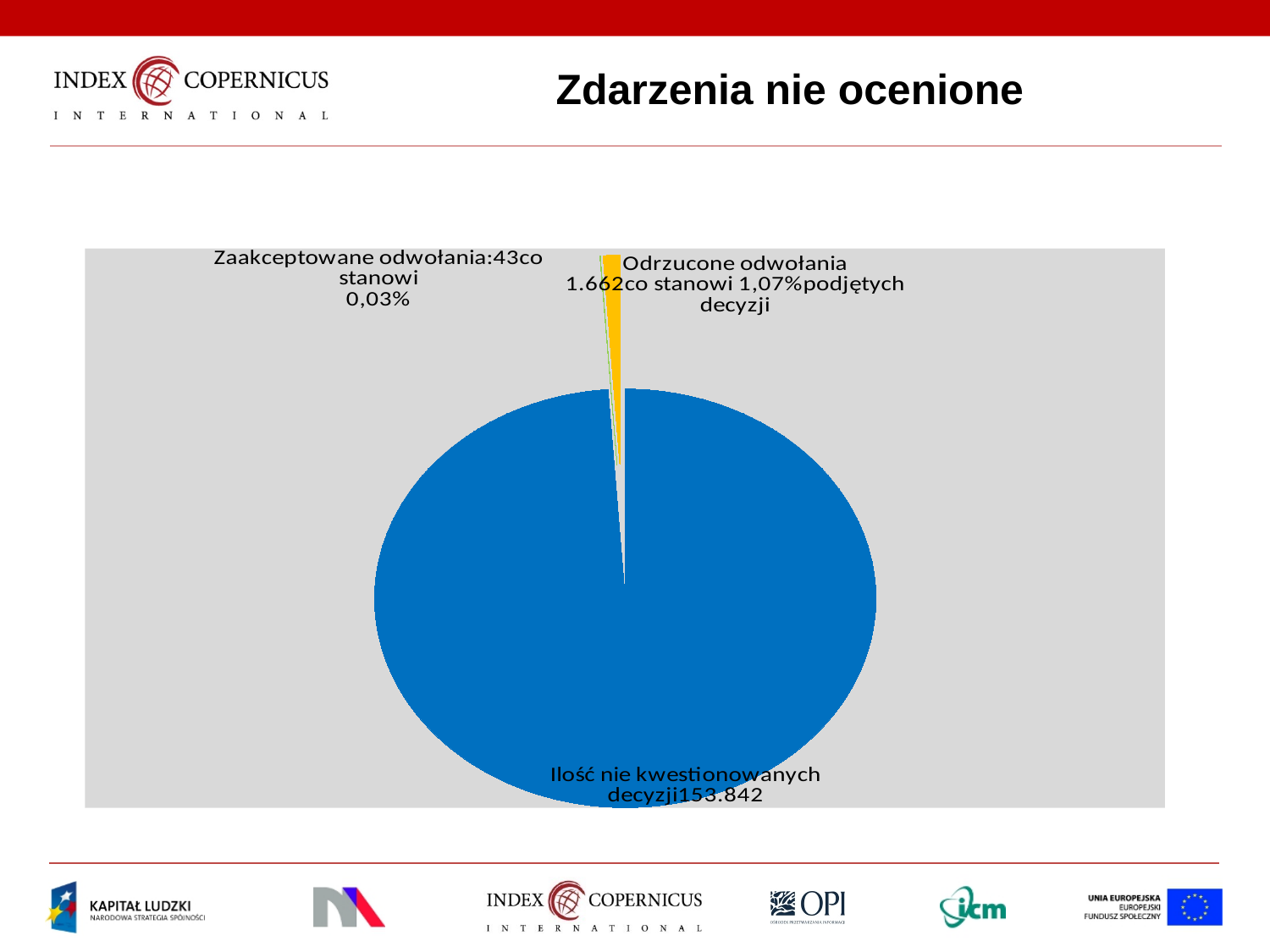
What is the value shown for "Zaakceptowane odwołania"? 43 What is the value shown for "Odrzucone odwołania"? 1.662 What kind of chart is shown on the slide? pie chart What colour is the slice for "Ilość nie kwestionowanych decyzji"? blue What is the difference between the value for "Odrzucone odwołania" and the value for "Zaakceptowane odwołania"? 1.619 Which slice of the pie chart is the smallest? Zaakceptowane odwołania Which slice of the pie chart is the largest? Ilość nie kwestionowanych decyzji How many slices does the pie chart have? 3 Which is larger, the value for "Odrzucone odwołania" or the value for "Zaakceptowane odwołania"? Odrzucone odwołania What percentage share is printed for "Zaakceptowane odwołania"? 0,03% What is the value shown for "Ilość nie kwestionowanych decyzji"? 153.842 What percentage share is printed for "Odrzucone odwołania"? 1,07%